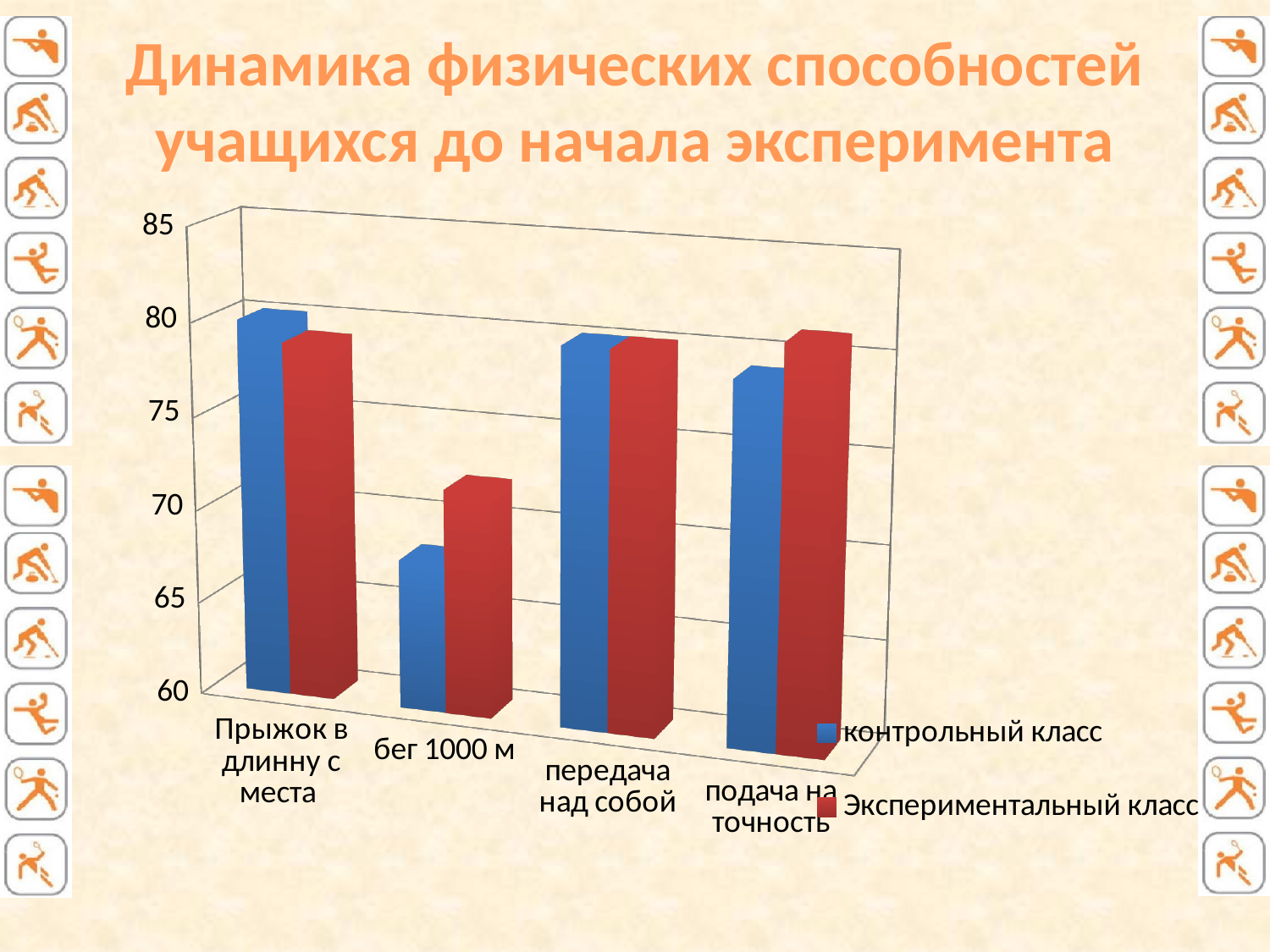
How many series does the chart legend list? 2 Which colour represents the series 'Экспериментальный класс' in the chart? red Is the value for 'контрольный класс' in 'бег 1000 м' greater or less than 70? less In the category 'бег 1000 м', which series has the larger value: 'контрольный класс' or 'Экспериментальный класс'? Экспериментальный класс For which category is the value of 'контрольный класс' the lowest? бег 1000 м For which category is the value of 'Экспериментальный класс' the lowest? бег 1000 м What is the title of the slide with the chart? Динамика физических способностей учащихся до начала эксперимента How many categories are shown on the x axis of the chart? 4 What kind of chart is shown on the slide? bar chart Is the value for 'Экспериментальный класс' in 'подача на точность' greater or less than 75? greater Is the value for 'контрольный класс' in 'Прыжок в длинну с места' greater or less than 75? greater In the category 'Прыжок в длинну с места', which series has the larger value: 'контрольный класс' or 'Экспериментальный класс'? контрольный класс